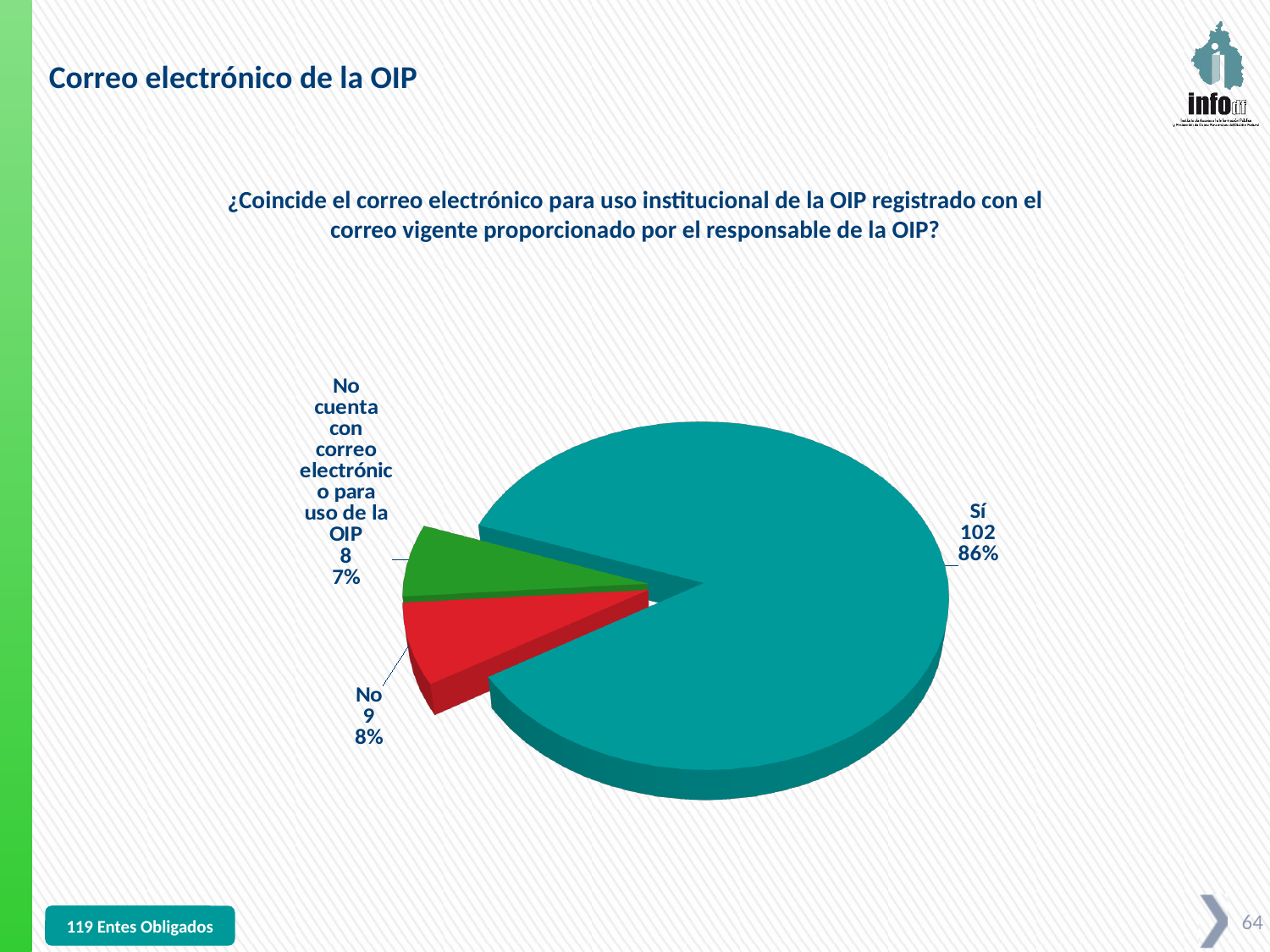
What kind of chart is shown on the slide? Pie chart What is the difference between the count for 'Sí' and the count for 'No'? 93 What percentage share does the 'No' slice represent? 8% What percentage share does the 'Sí' slice represent? 86% How many slices does the pie chart have? 3 What is the count for the 'No' slice? 9 Which category has the largest slice? Sí Which category has the smallest slice? No cuenta con correo electrónico para uso de la OIP What percentage share does the 'No cuenta con correo electrónico para uso de la OIP' slice represent? 7% What is the total number of entities represented in the pie chart? 119 What is the count for the 'Sí' slice? 102 What is the count for the 'No cuenta con correo electrónico para uso de la OIP' slice? 8